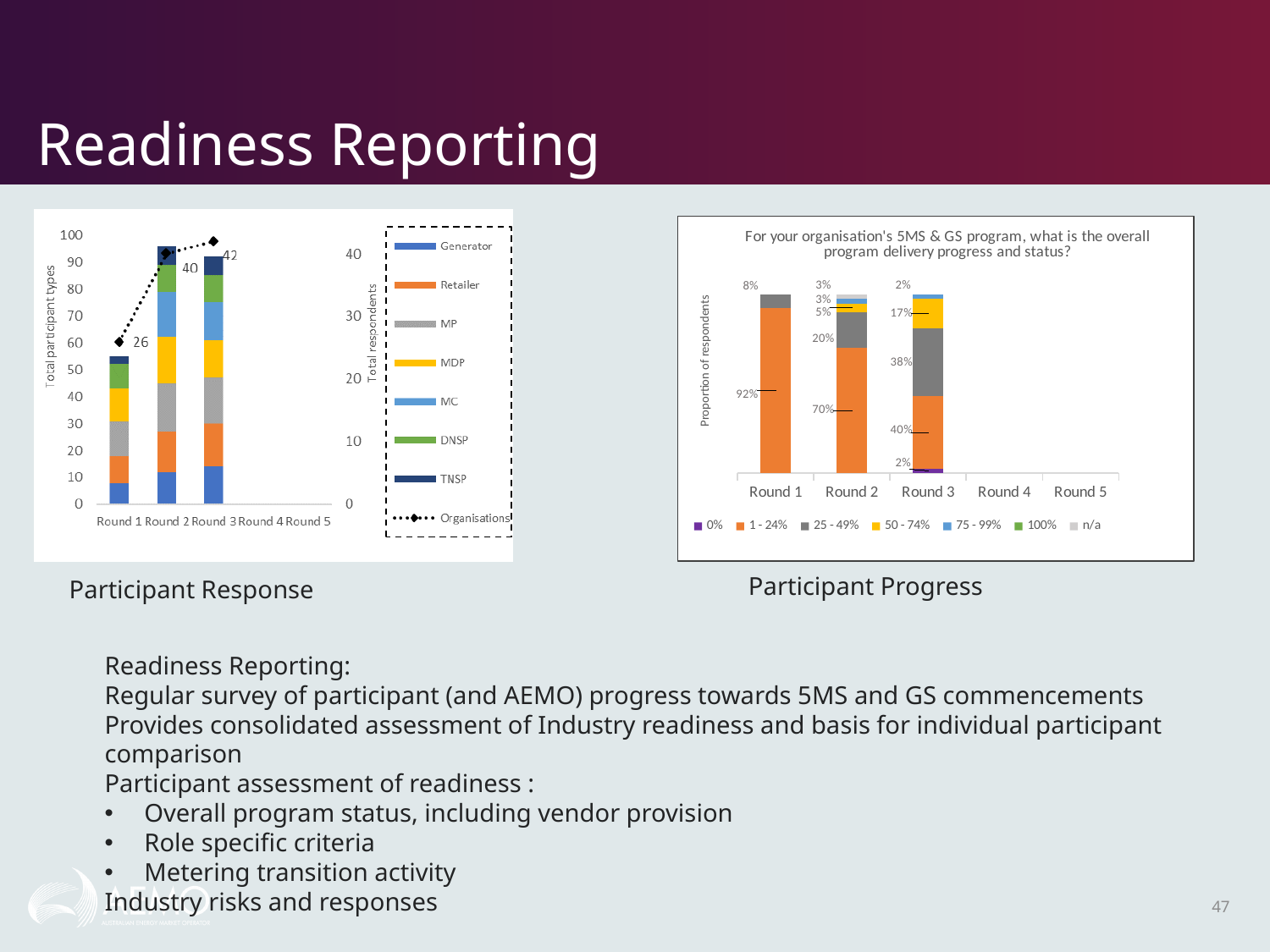
In the Participant Progress chart, what percentage of respondents reported 1 - 24% progress in Round 1? 92% What kind of chart is the Participant Progress chart? stacked bar chart In the Participant Response chart, what is the Organisations value for Round 1? 26 How many entries does the legend of the Participant Response chart list? 8 In the Participant Progress chart, what is the difference between the 1 - 24% share in Round 2 and in Round 3? 30% In the Participant Response chart, which round has the highest Organisations value? Round 3 How many entries does the legend of the Participant Progress chart list? 7 In the Participant Response chart, what is the difference between the Organisations values for Round 2 and Round 1? 14 In the Participant Progress chart, what percentage of respondents reported 25 - 49% progress in Round 3? 38% In the Participant Progress chart, what percentage of respondents reported 50 - 74% progress in Round 3? 17% In the Participant Progress chart, does the 1 - 24% share rise or fall from Round 1 to Round 3? fall In the Participant Response chart, what is the Organisations value for Round 3? 42